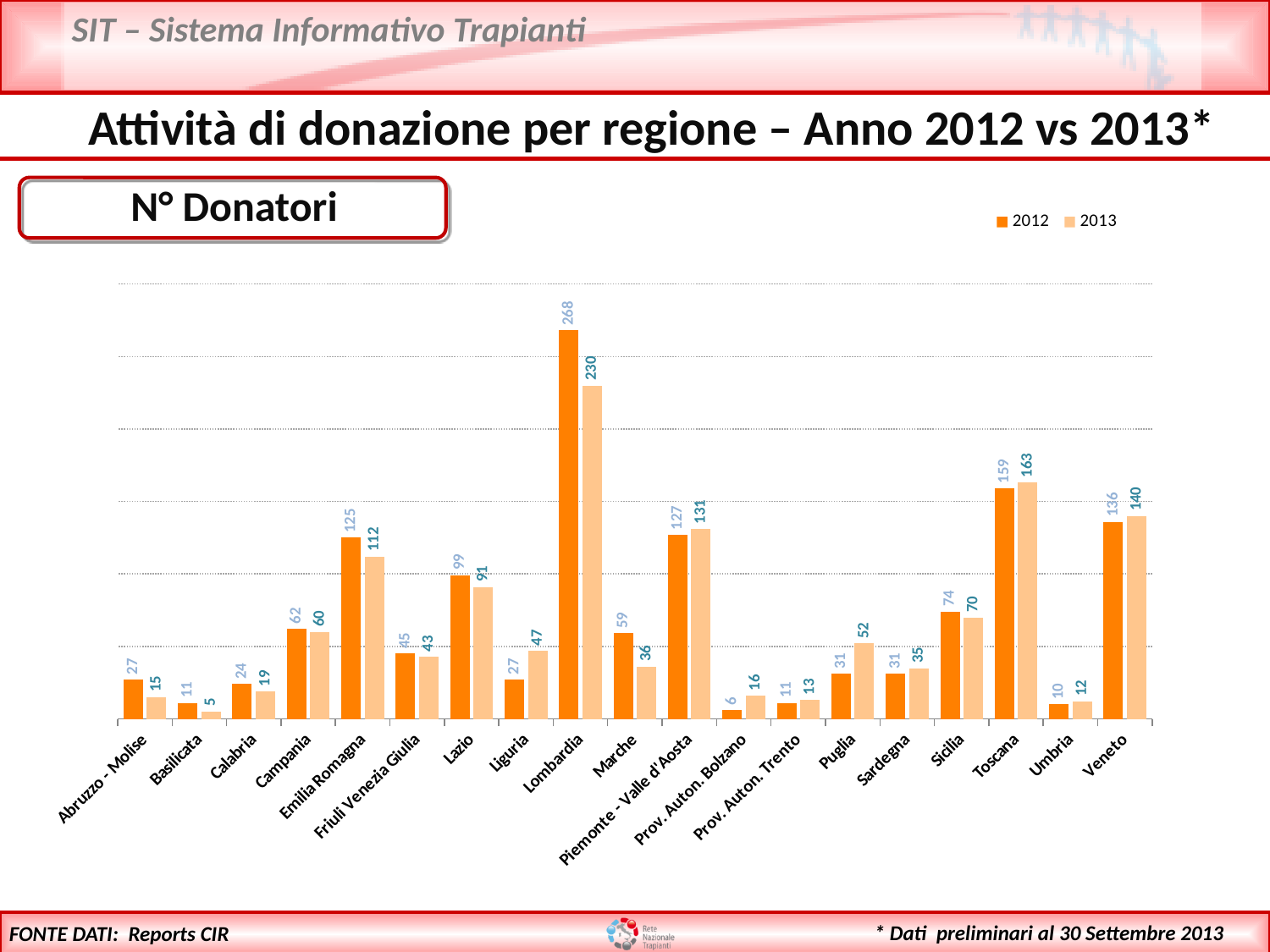
Which region has the lowest number of donors in 2013? Basilicata What is the difference between the 2012 and 2013 values for Liguria? 20 For Puglia, which year has the larger number of donors, 2012 or 2013? 2013 What is the difference between the 2012 and 2013 values for Lombardia? 38 What kind of chart is shown on the slide? Bar chart Which is larger: the 2012 value for Emilia Romagna or the 2012 value for Veneto? Veneto How many series does the legend list? 2 What is the number of donors for Lombardia in 2012? 268 How many regions are shown on the x axis? 19 Which region has the highest number of donors in 2012? Lombardia What is the 2013 value for Prov. Auton. Bolzano? 16 What is the number of donors for Toscana in 2013? 163